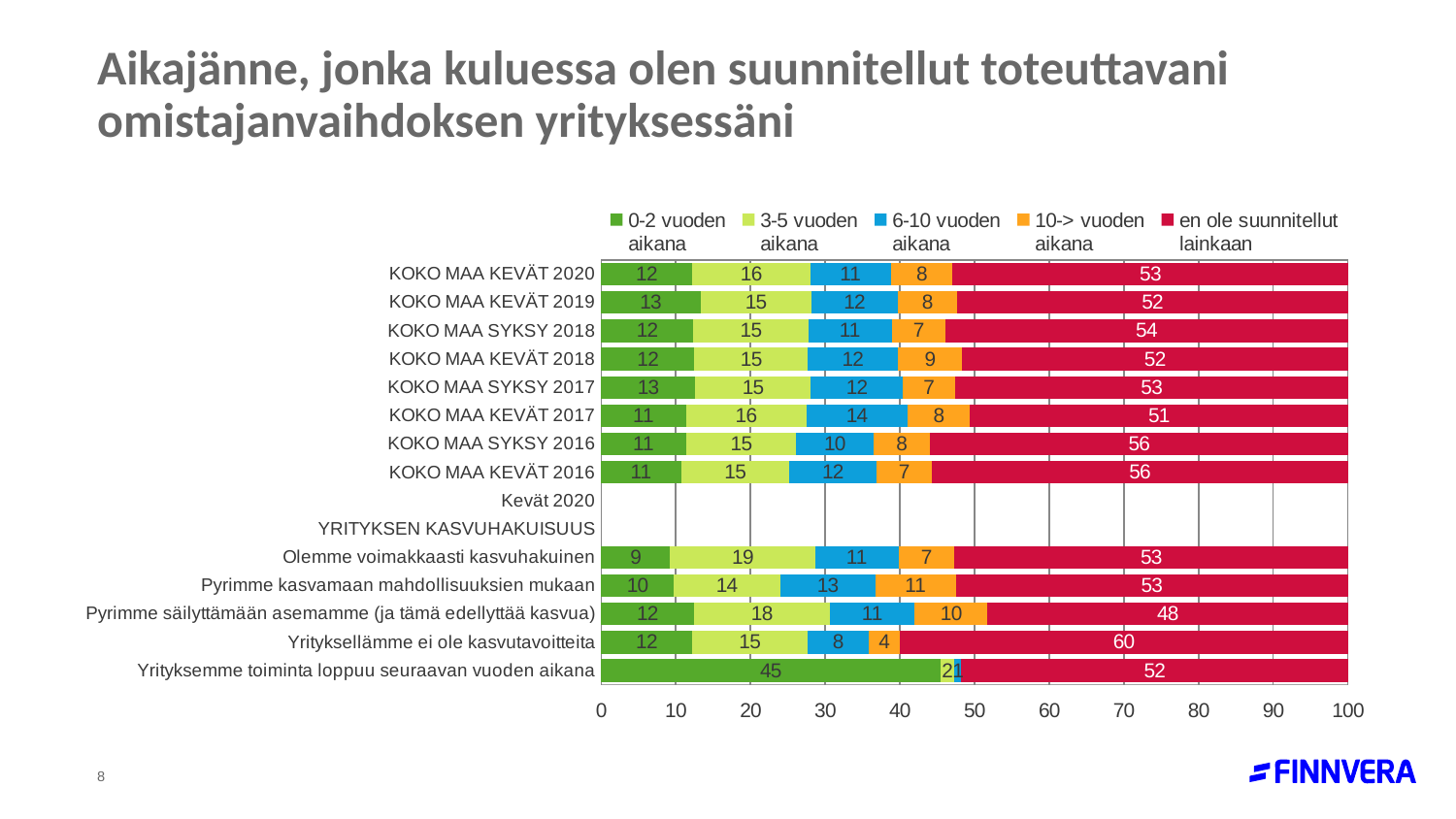
How many series does the legend list? 5 What is the value of "3-5 vuoden aikana" for Olemme voimakkaasti kasvuhakuinen? 19 What is the value of "en ole suunnitellut lainkaan" for KOKO MAA KEVÄT 2020? 53 What is the value of "0-2 vuoden aikana" for KOKO MAA KEVÄT 2019? 13 What is the difference between the "en ole suunnitellut lainkaan" values for KOKO MAA SYKSY 2016 and KOKO MAA KEVÄT 2017? 5 Which category has the lowest value for "en ole suunnitellut lainkaan"? Pyrimme säilyttämään asemamme (ja tämä edellyttää kasvua) What is the value of "0-2 vuoden aikana" for Yrityksemme toiminta loppuu seuraavan vuoden aikana? 45 What is the total of the stacked bar for KOKO MAA KEVÄT 2020? 100 Which category has the highest value for "en ole suunnitellut lainkaan"? Yrityksellämme ei ole kasvutavoitteita What kind of chart is shown on the slide? stacked bar chart What is the value of "10-> vuoden aikana" for Pyrimme kasvamaan mahdollisuuksien mukaan? 11 Which is larger: the "6-10 vuoden aikana" value for KOKO MAA KEVÄT 2017 or for KOKO MAA SYKSY 2016? KOKO MAA KEVÄT 2017